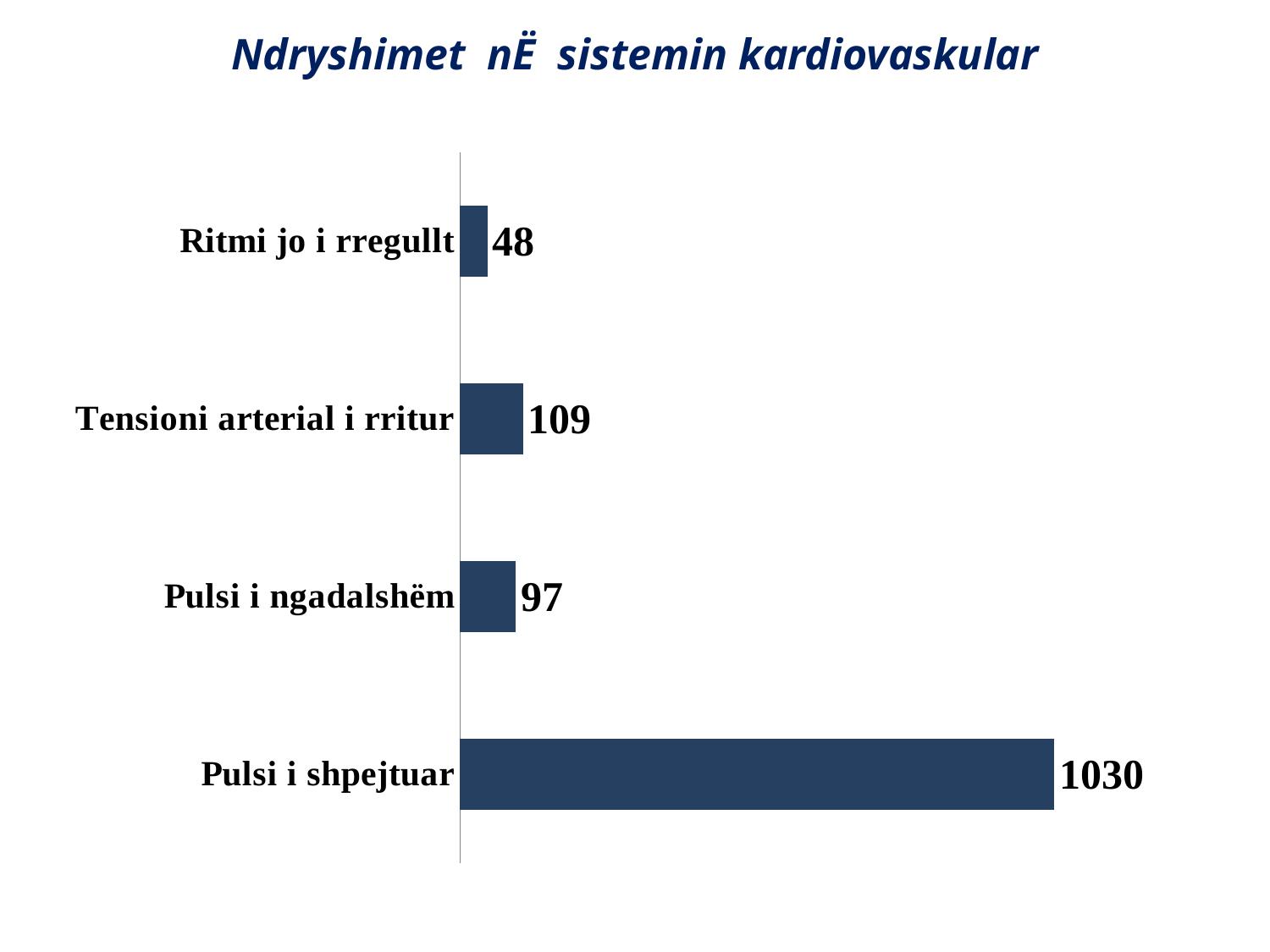
What is the difference between the values for Pulsi i shpejtuar and Tensioni arterial i rritur? 921 What is the value for Pulsi i ngadalshëm? 97 Which category has the lowest value? Ritmi jo i rregullt Which category has the highest value? Pulsi i shpejtuar What kind of chart is shown on the slide? Bar chart Which is larger, the value for Pulsi i ngadalshëm or the value for Ritmi jo i rregullt? Pulsi i ngadalshëm What is the difference between the values for Tensioni arterial i rritur and Pulsi i ngadalshëm? 12 What is the value for Ritmi jo i rregullt? 48 What is the value for Pulsi i shpejtuar? 1030 What is the value for Tensioni arterial i rritur? 109 How many categories are shown in the chart? 4 What is the title of the slide? Ndryshimet nË sistemin kardiovaskular